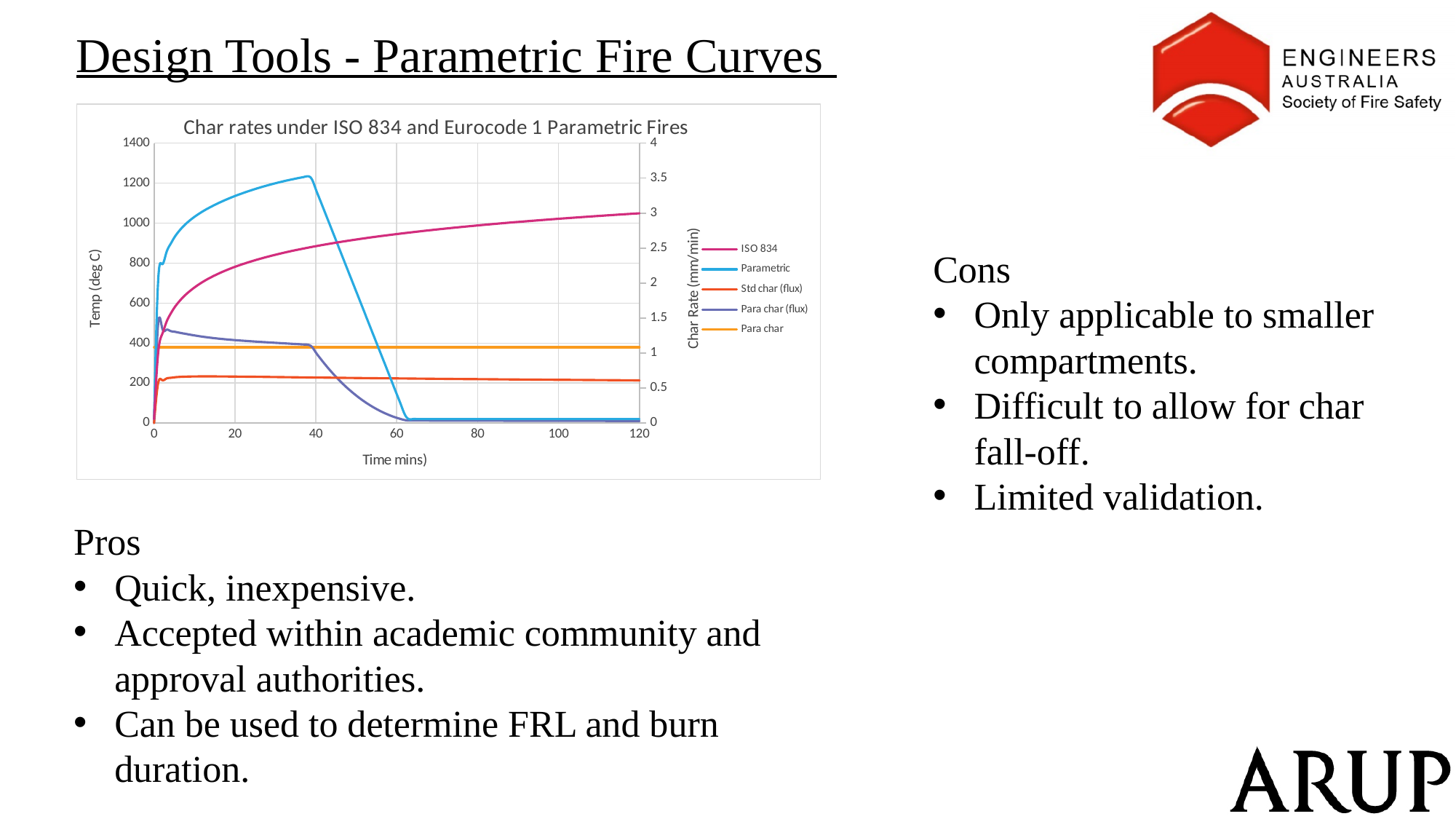
Is the ISO 834 temperature at 120 minutes greater or less than 1000? greater What is the label of the right-hand vertical axis of the chart? Char Rate (mm/min) How many series does the chart legend list? 5 What is the title of the chart? Char rates under ISO 834 and Eurocode 1 Parametric Fires What kind of chart is shown on the slide? line chart Is the Para char (flux) char rate at 100 minutes greater or less than 0.5? less Is the Parametric temperature at 80 minutes greater or less than 200? less At 20 minutes, which is higher: the Parametric temperature or the ISO 834 temperature? Parametric Does the ISO 834 temperature rise or fall as time increases from 0 to 120 minutes? rise Which temperature curve reaches the highest peak value, ISO 834 or Parametric? Parametric